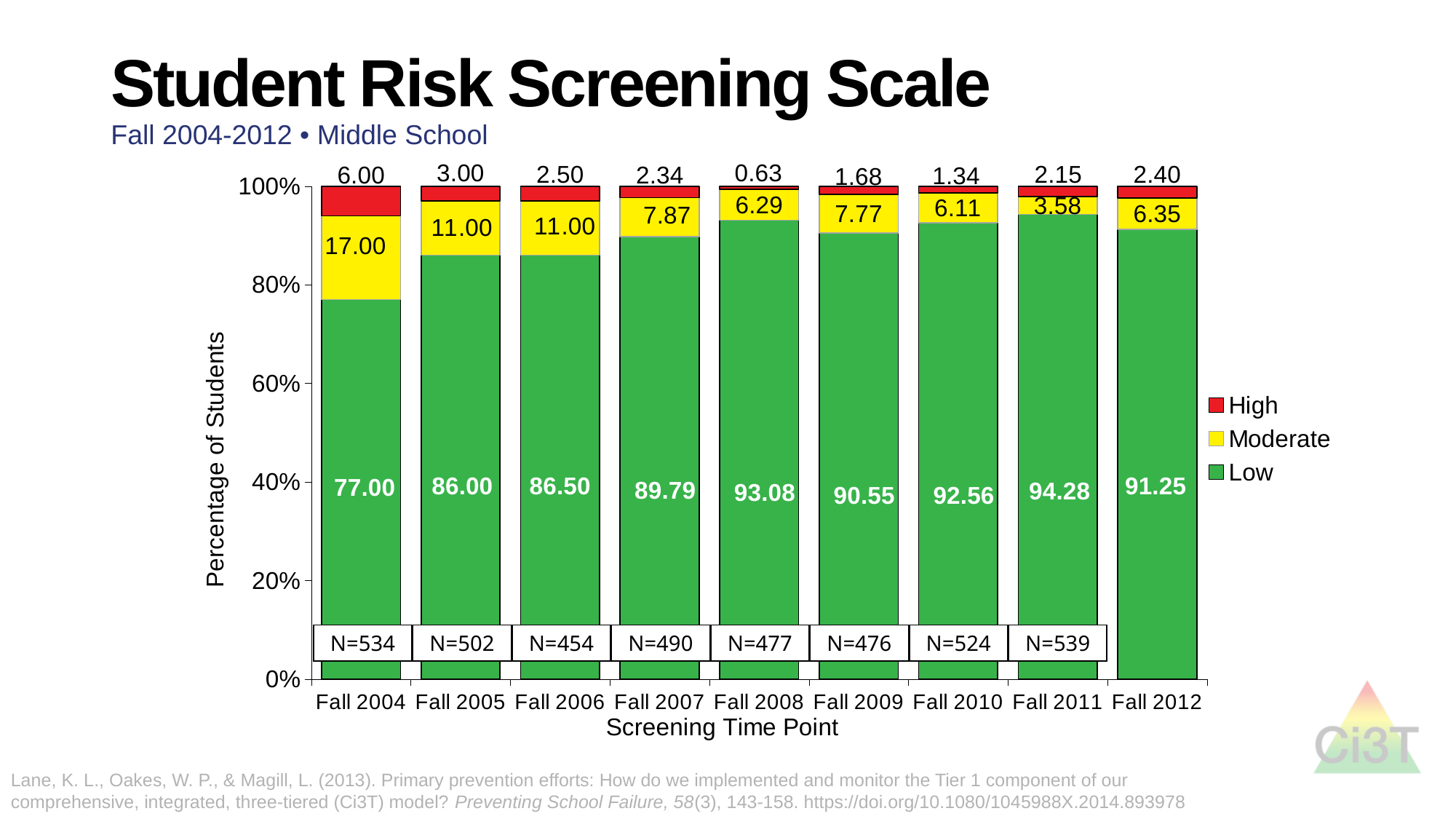
What is the N value shown for Fall 2006? N=454 What is the difference between the Low values for Fall 2011 and Fall 2004? 17.28 What is the High value for Fall 2008? 0.63 How many series does the legend list? 3 What is the Moderate value for Fall 2007? 7.87 Which screening time point has the lowest High value? Fall 2008 What kind of chart is shown on the slide? Stacked bar chart How many screening time points are shown on the x axis? 9 Which screening time point has the highest Low value? Fall 2011 What is the Low value for Fall 2004? 77.00 Which is larger, the Moderate value for Fall 2009 or the Moderate value for Fall 2010? Fall 2009 What is the total of the Low, Moderate and High values for Fall 2005? 100.00